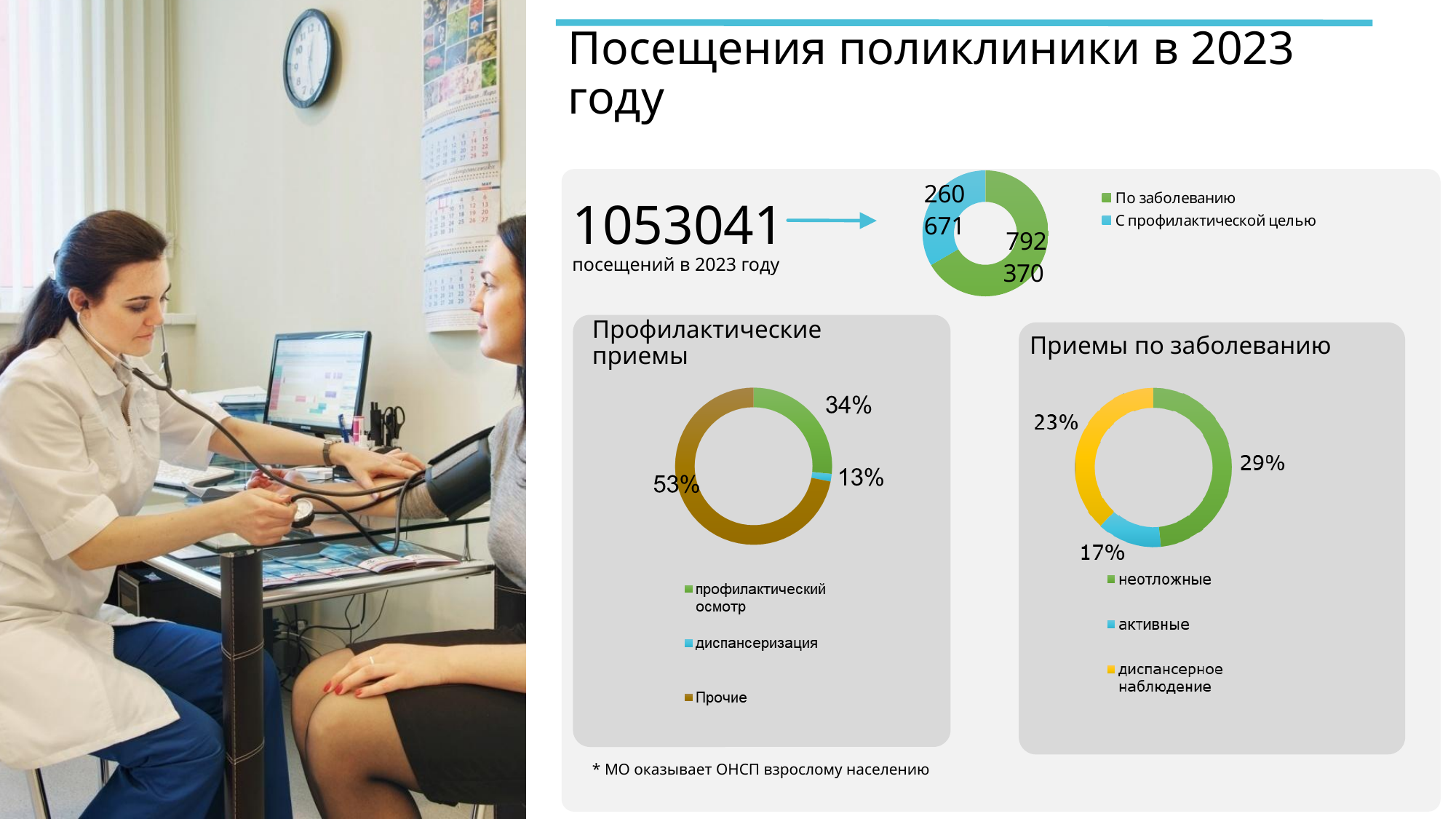
What type of chart is used in the 'Приемы по заболеванию' panel? Donut (pie) chart How many series does the legend of the top donut chart list? 2 In the 'Профилактические приемы' chart, which category has the largest share? Прочие In the 'Профилактические приемы' chart, what share is 'профилактический осмотр'? 34% In the top donut chart, what is the value for 'По заболеванию'? 792 370 In the 'Профилактические приемы' chart, what is the difference between the shares of 'Прочие' and 'профилактический осмотр'? 19% In the 'Приемы по заболеванию' chart, which category has the smallest share? активные In the top donut chart, what is the value for 'С профилактической целью'? 260 671 In the 'Профилактические приемы' chart, what share is 'диспансеризация'? 13% In the top donut chart, which category is larger: 'По заболеванию' or 'С профилактической целью'? По заболеванию In the 'Приемы по заболеванию' chart, what is the difference between the shares of 'неотложные' and 'диспансерное наблюдение'? 6% In the 'Приемы по заболеванию' chart, what share is 'активные'? 17%